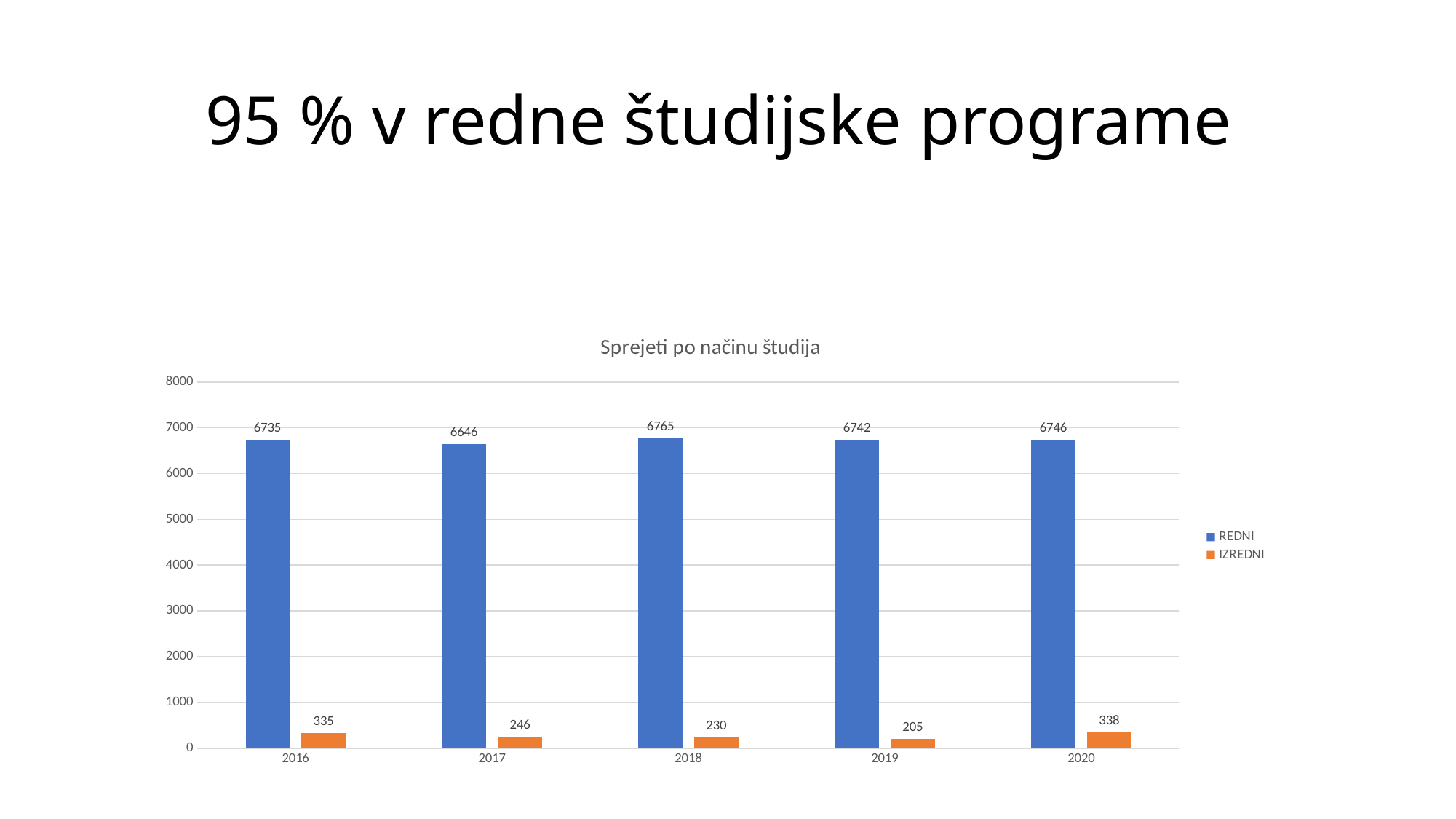
How many series does the legend list? 2 What kind of chart is shown? bar chart How many years are shown on the x axis? 5 What is the title of the chart? Sprejeti po načinu študija Which is larger, the IZREDNI value for 2017 or for 2018? 2017 Which year has the lowest REDNI value? 2017 What is the REDNI value for 2017? 6646 What is the REDNI value for 2018? 6765 Is the REDNI value for 2019 greater or less than 6000? greater Which year has the highest IZREDNI value? 2020 What is the IZREDNI value for 2019? 205 What is the difference between the REDNI and IZREDNI values in 2016? 6400